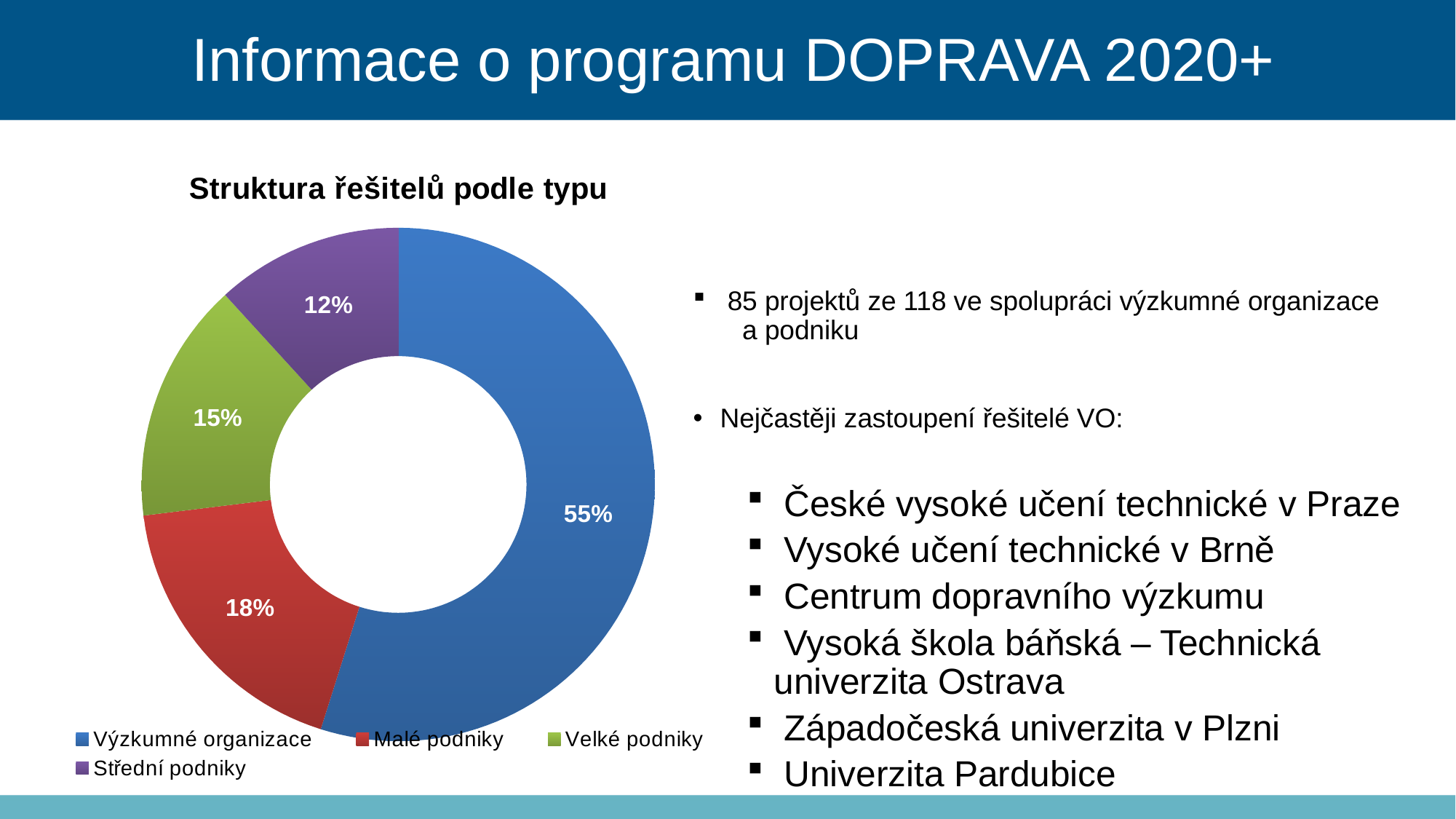
What is the difference in percentage points between Výzkumné organizace and Malé podniky? 37 What is the difference in percentage points between Velké podniky and Střední podniky? 3 What share of the pie does Malé podniky hold? 18% Which category has the smallest share of the pie? Střední podniky What kind of chart is shown on the slide? Pie chart (doughnut) What share of the pie does Střední podniky hold? 12% Which category has the largest share of the pie? Výzkumné organizace Which has a larger share, Malé podniky or Velké podniky? Malé podniky How many categories does the pie chart show? 4 What is the title of the chart? Struktura řešitelů podle typu What share of the pie does Výzkumné organizace hold? 55% What share of the pie does Velké podniky hold? 15%